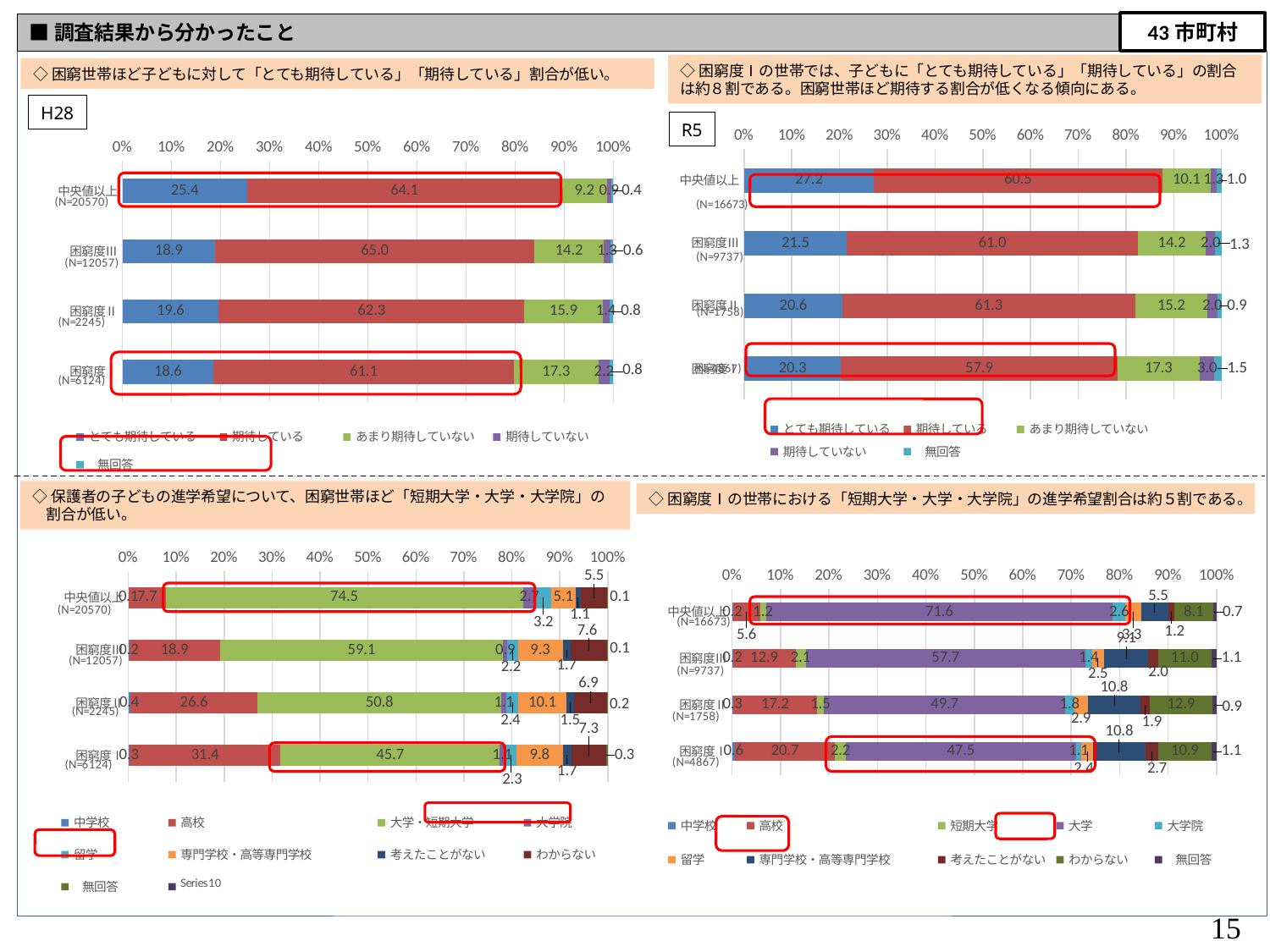
In the top-right R5 chart, what is the value of 「期待している」 for 困窮度I? 57.9 In the top-right R5 chart, is the 「あまり期待していない」 value larger for 中央値以上 or for 困窮度I? 困窮度I What type of chart is the top-left H28 chart? Stacked bar chart In the top-left H28 chart, what is the value of 「とても期待している」 for 困窮度I? 18.6 In the bottom-right chart, what is the value of 「大学」 for 困窮度I? 47.5 In the bottom-left chart, what is the value of 「大学・短期大学」 for 困窮度I? 45.7 In the top-left H28 chart, which category has the highest value for 「あまり期待していない」? 困窮度I In the top-left H28 chart, what is the difference between the 「とても期待している」 values for 中央値以上 and 困窮度I? 6.8 In the bottom-left chart, which category has the lowest value for 「大学・短期大学」? 困窮度I How many series does the legend of the top-right R5 chart list? 5 In the top-right R5 chart, which category has the highest value for 「とても期待している」? 中央値以上 In the top-left H28 chart, what is the value of 「期待している」 for 中央値以上? 64.1